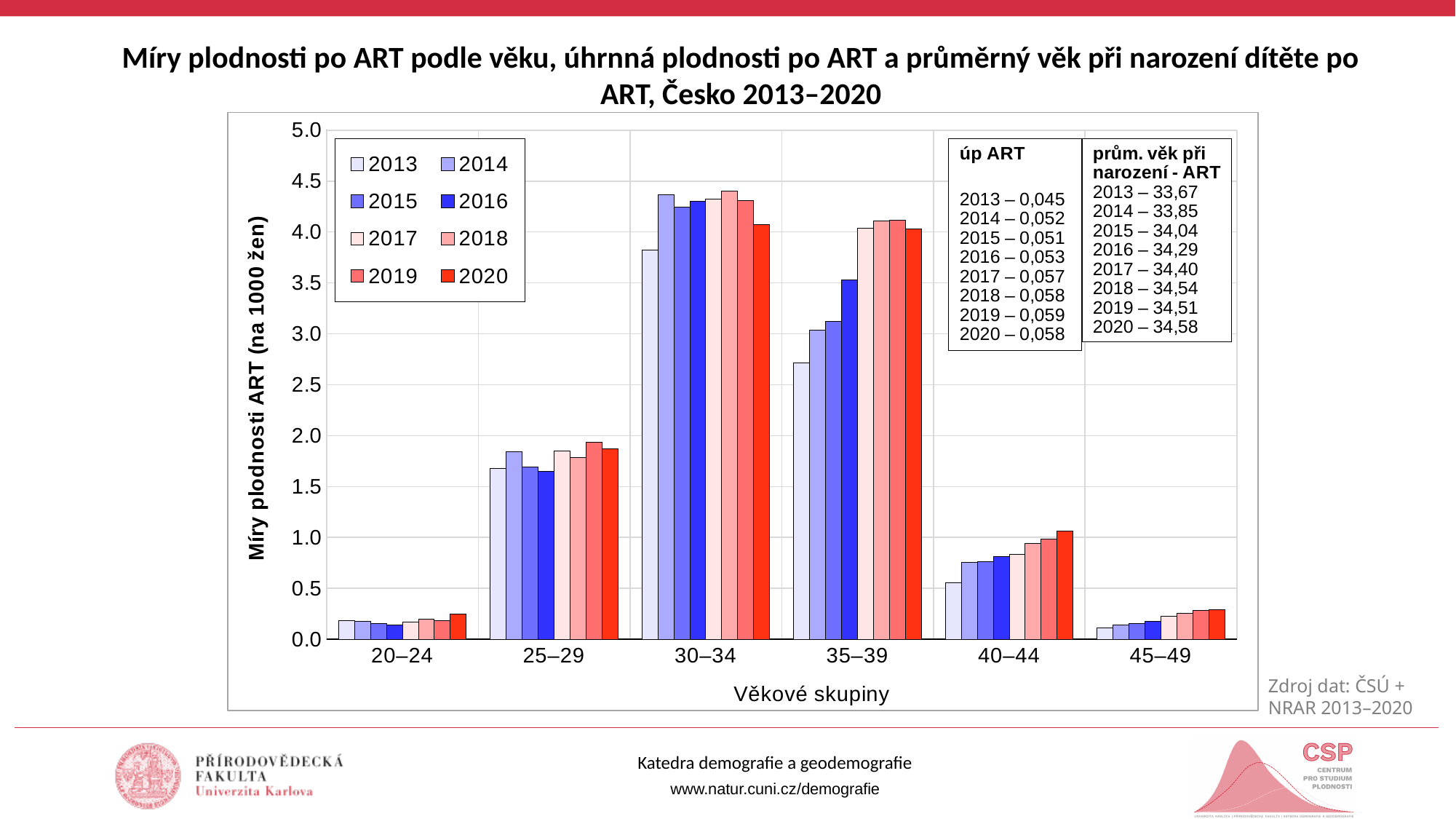
What kind of chart is shown on the slide? bar chart In the 40–44 age group, do the values rise or fall from 2013 to 2020? rise For 2013, which age group has the larger value: 30–34 or 35–39? 30–34 How many age groups are shown on the x axis of the chart? 6 According to the 'prům. věk při narození - ART' box on the chart, what is the value for 2013? 33,67 According to the 'úp ART' box on the chart, what is the value for 2020? 0,058 Is the 2013 value for the 35–39 age group greater or less than 3.0? less How many series (years) does the chart legend list? 8 Is the 2013 value for the 40–44 age group greater or less than 1.0? less Which age group has the highest ART fertility rates in the chart? 30–34 Within the 30–34 age group, which year has the lowest bar? 2013 Is the 2020 value for the 25–29 age group greater or less than 1.5? greater